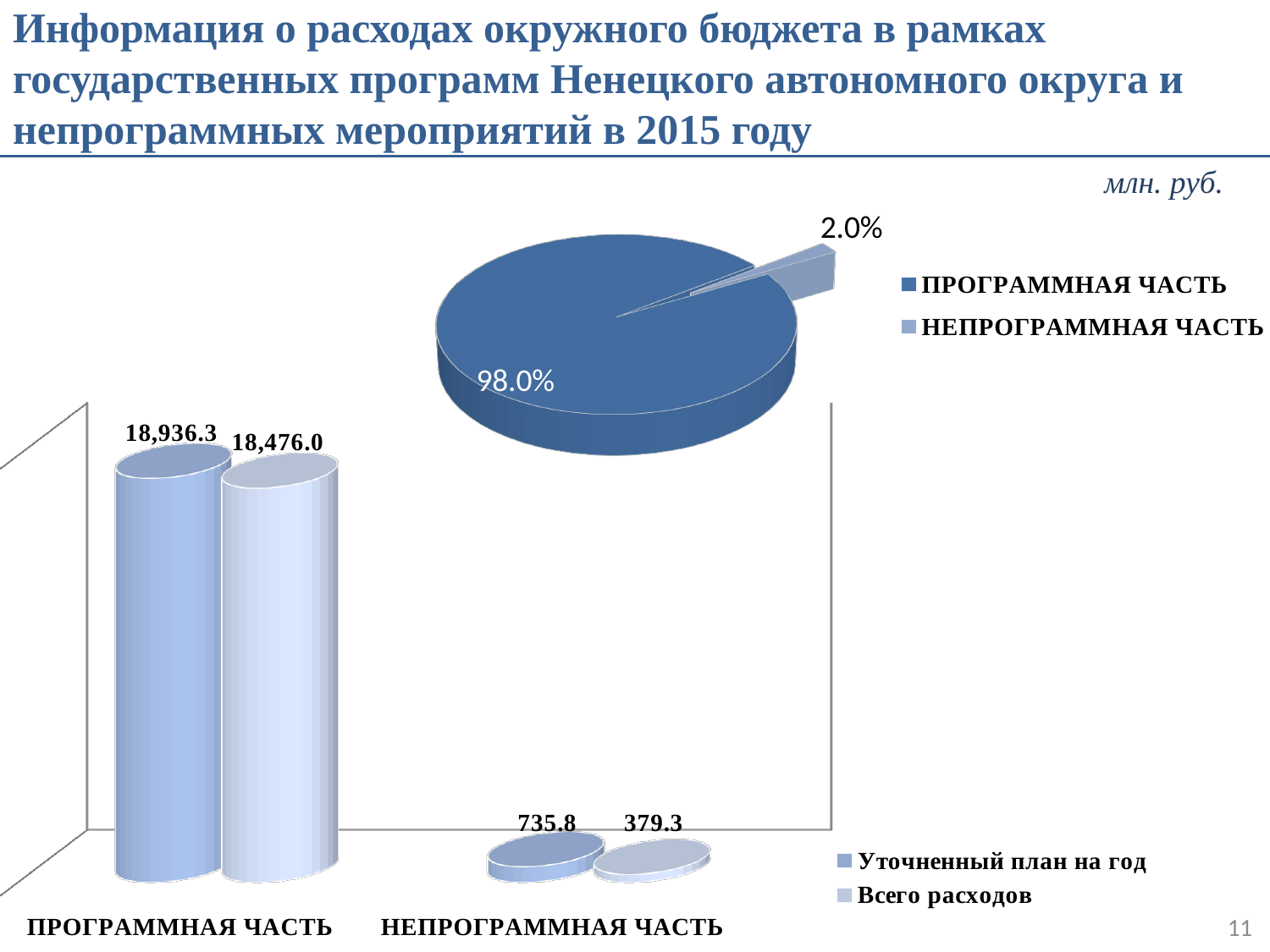
In the bar chart at the bottom left, what is the value of Уточненный план на год for ПРОГРАММНАЯ ЧАСТЬ? 18,936.3 In the pie chart at the top right, what share does ПРОГРАММНАЯ ЧАСТЬ have? 98.0% In the bar chart at the bottom left, what is the difference between Уточненный план на год and Всего расходов for НЕПРОГРАММНАЯ ЧАСТЬ? 356.5 In the bar chart at the bottom left, what is the value of Всего расходов for НЕПРОГРАММНАЯ ЧАСТЬ? 379.3 In the bar chart at the bottom left, which category has the higher Уточненный план на год value? ПРОГРАММНАЯ ЧАСТЬ In the bar chart at the bottom left, how many categories are shown? 2 In the bar chart at the bottom left, how many series does the legend list? 2 In the pie chart at the top right, what share does НЕПРОГРАММНАЯ ЧАСТЬ have? 2.0% In the bar chart at the bottom left, what is the difference between Уточненный план на год and Всего расходов for ПРОГРАММНАЯ ЧАСТЬ? 460.3 In the bar chart at the bottom left, what is the value of Всего расходов for ПРОГРАММНАЯ ЧАСТЬ? 18,476.0 What kind of chart is shown at the top right of the slide? Pie chart In the bar chart at the bottom left, what is the value of Уточненный план на год for НЕПРОГРАММНАЯ ЧАСТЬ? 735.8